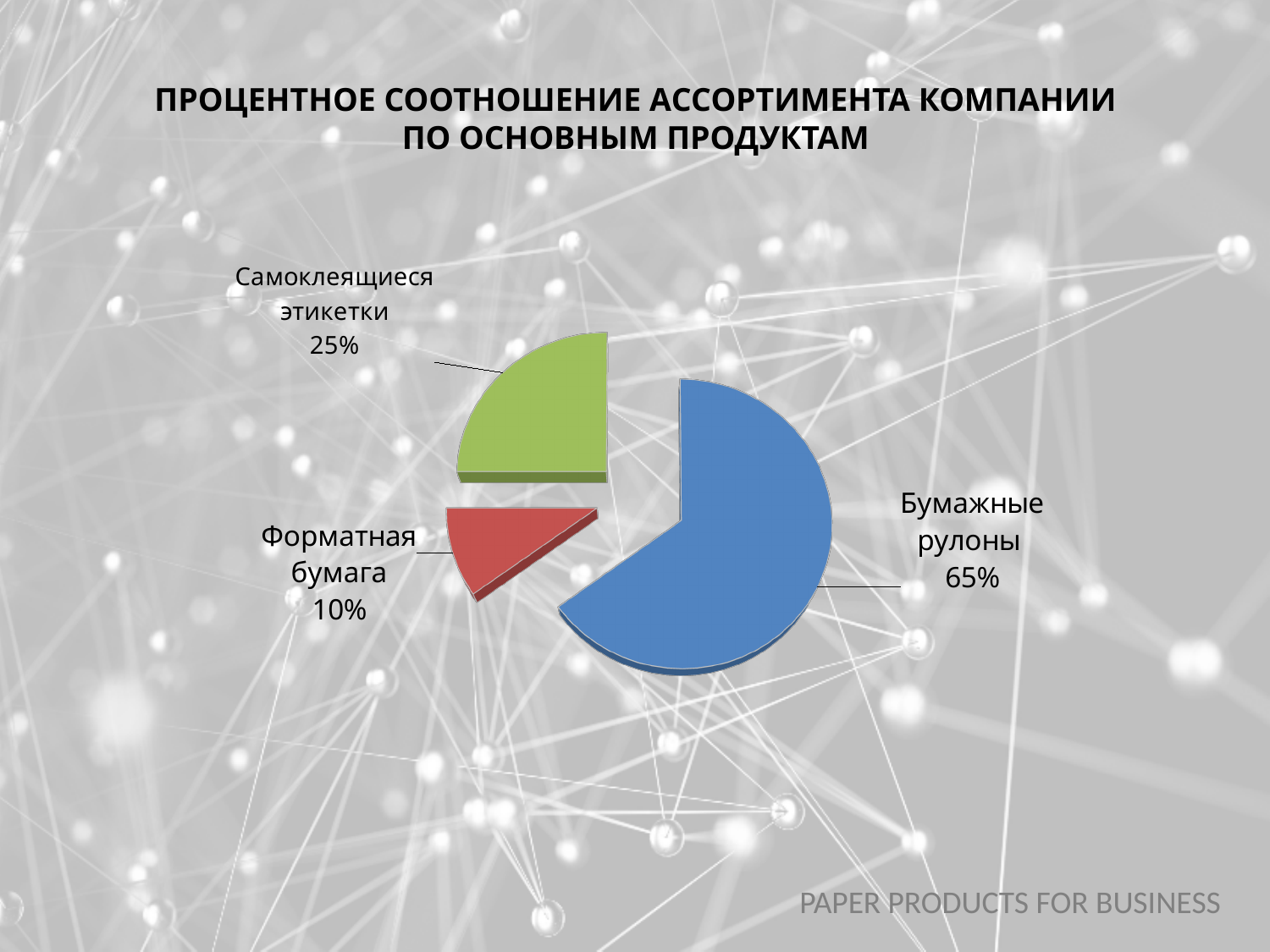
What is the difference in percentage points between Самоклеящиеся этикетки and Форматная бумага? 15 What colour is the slice for Бумажные рулоны? Blue What share of the pie does Бумажные рулоны have? 65% What is the title of the chart on the slide? ПРОЦЕНТНОЕ СООТНОШЕНИЕ АССОРТИМЕНТА КОМПАНИИ ПО ОСНОВНЫМ ПРОДУКТАМ What kind of chart is shown on the slide? Pie chart How many categories are shown in the pie chart? 3 What share of the pie does Самоклеящиеся этикетки have? 25% Which is larger: the share for Самоклеящиеся этикетки or the share for Форматная бумага? Самоклеящиеся этикетки Which category has the smallest slice of the pie? Форматная бумага What share of the pie does Форматная бумага have? 10% What is the difference in percentage points between Бумажные рулоны and Самоклеящиеся этикетки? 40 Which category has the largest slice of the pie? Бумажные рулоны